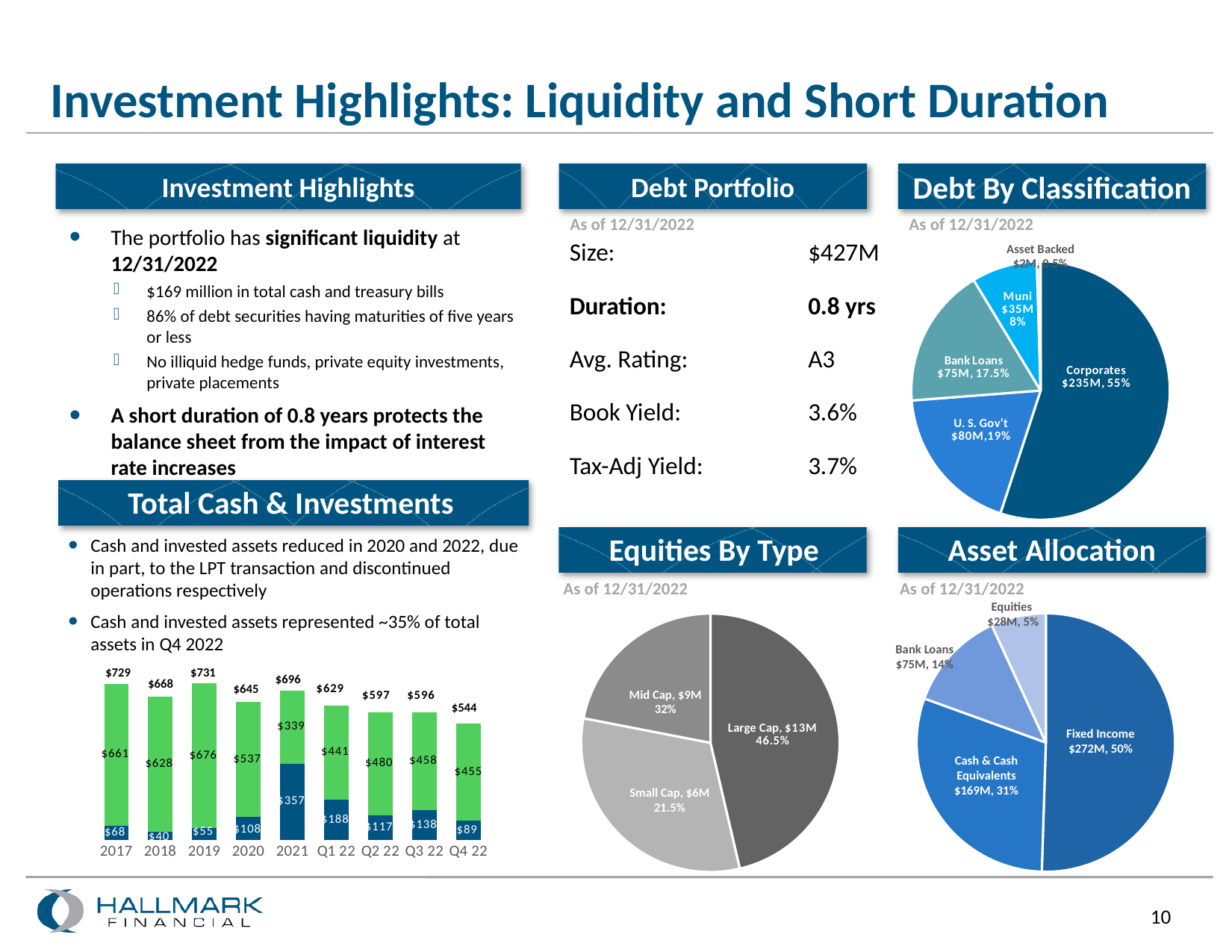
In the Asset Allocation pie chart, what is the difference in dollar value between Fixed Income and Cash & Cash Equivalents? $103M In the Debt By Classification pie chart, how many slices are there? 5 In the Total Cash & Investments bar chart, how many periods are shown on the x axis? 9 What kind of chart is the Total Cash & Investments chart? Stacked bar chart In the Total Cash & Investments bar chart, which period has the lowest total? Q4 22 In the Total Cash & Investments bar chart, what is the total value shown for 2019? $731 In the Debt By Classification pie chart, what value is shown for Corporates? $235M, 55% In the Total Cash & Investments bar chart, what is the value of the dark blue segment for 2021? $357 In the Asset Allocation pie chart, which category is the largest? Fixed Income In the Debt By Classification pie chart, which category is the smallest? Asset Backed In the Total Cash & Investments bar chart, what is the difference between the totals for 2017 and Q4 22? $185 In the Equities By Type pie chart, what share does Mid Cap represent? 32%